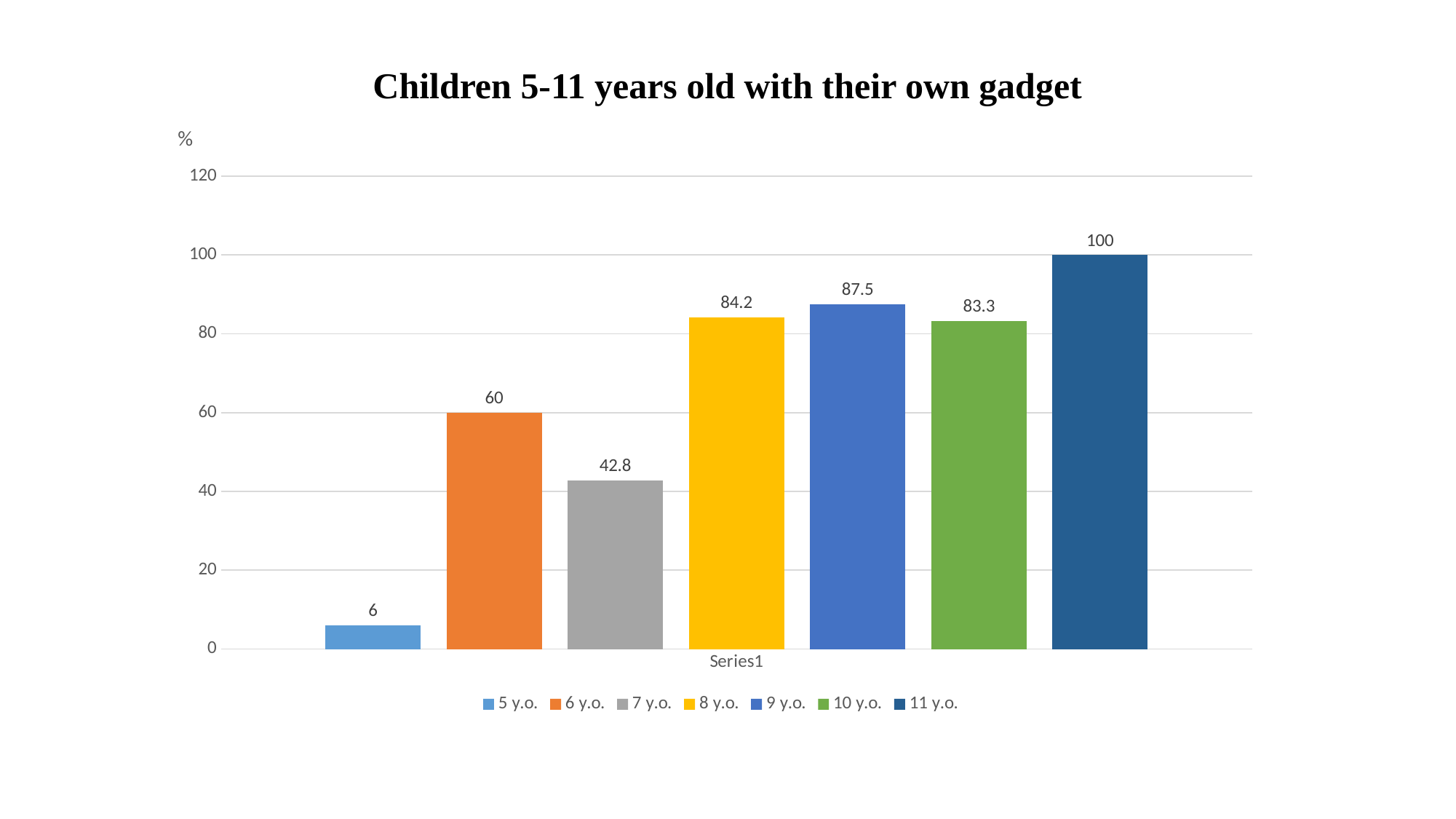
Which age group has the highest value? 11 y.o. What is the value for 9 y.o.? 87.5 Which is larger, the value for 6 y.o. or the value for 7 y.o.? 6 y.o. What is the value for 7 y.o.? 42.8 What is the difference between the values for 11 y.o. and 6 y.o.? 40 What is the value for 10 y.o.? 83.3 Which age group has the lowest value? 5 y.o. What is the difference between the values for 8 y.o. and 7 y.o.? 41.4 What kind of chart is shown on the slide? Bar chart How many age groups does the legend list? 7 What is the title of the chart? Children 5-11 years old with their own gadget What is the value for 5 y.o.? 6